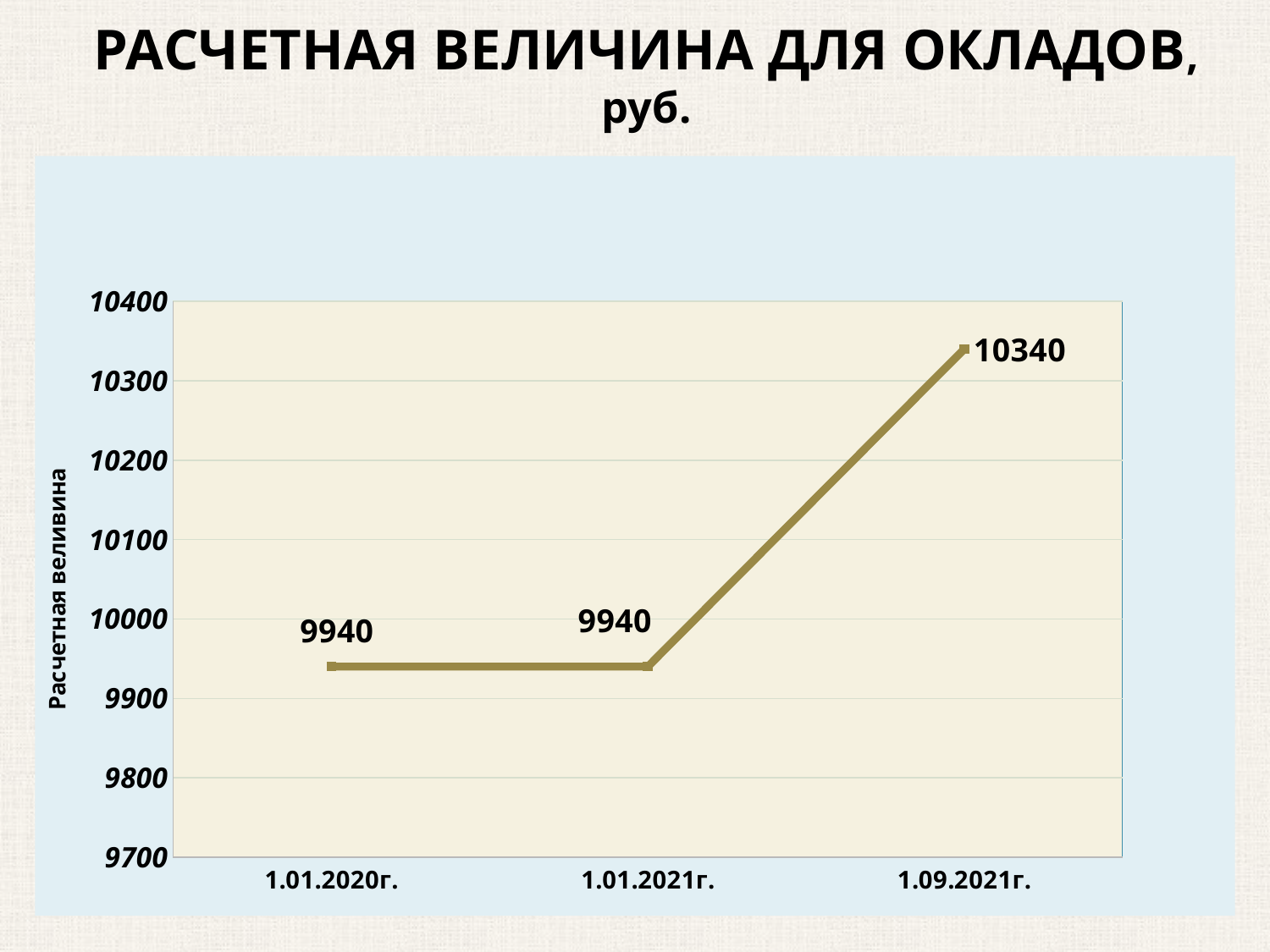
Do the values rise or fall from 1.01.2021г. to 1.09.2021г.? rise Which date has the highest value? 1.09.2021г. Is the value for 1.09.2021г. greater or less than 10300? greater Which is larger, the value for 1.09.2021г. or the value for 1.01.2020г.? 1.09.2021г. What is the label of the vertical axis? Расчетная веливина What is the value for 1.09.2021г.? 10340 What is the difference between the values for 1.09.2021г. and 1.01.2021г.? 400 What is the value for 1.01.2020г.? 9940 Is the value for 1.01.2020г. greater or less than 10000? less What is the value for 1.01.2021г.? 9940 How many data points are plotted on the chart? 3 What kind of chart is shown on the slide? line chart